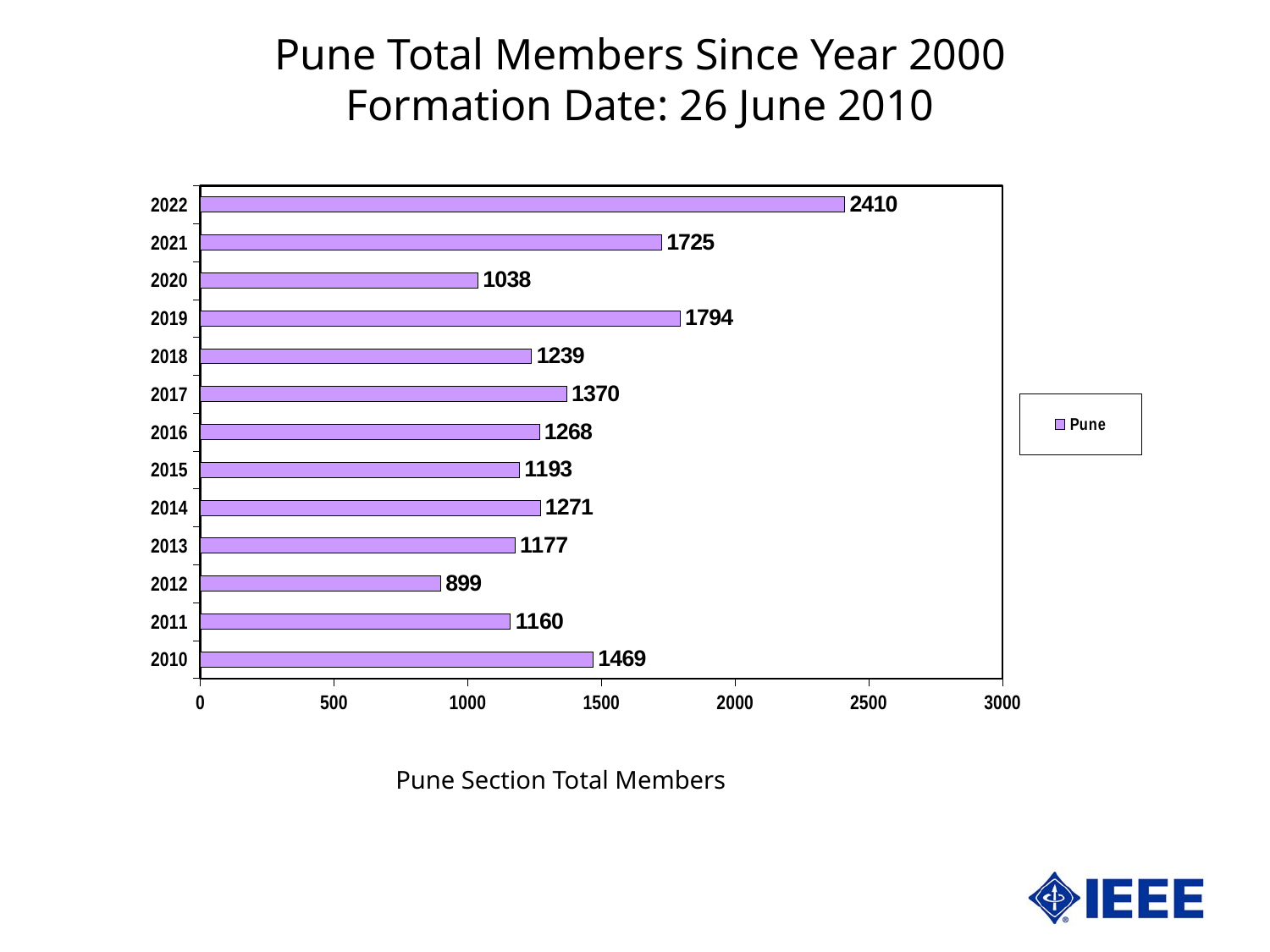
What is the difference between the values for 2022 and 2021? 685 How many series does the legend list? 1 Which year has the lowest value? 2012 What is the value for 2022? 2410 What is the name of the series in the legend? Pune Is the value for 2020 greater or less than 1000? greater Which is larger, the value for 2017 or the value for 2018? 2017 Which year has the highest value? 2022 How many years are shown on the chart? 13 What kind of chart is shown? bar chart What is the value for 2012? 899 What is the value for 2019? 1794